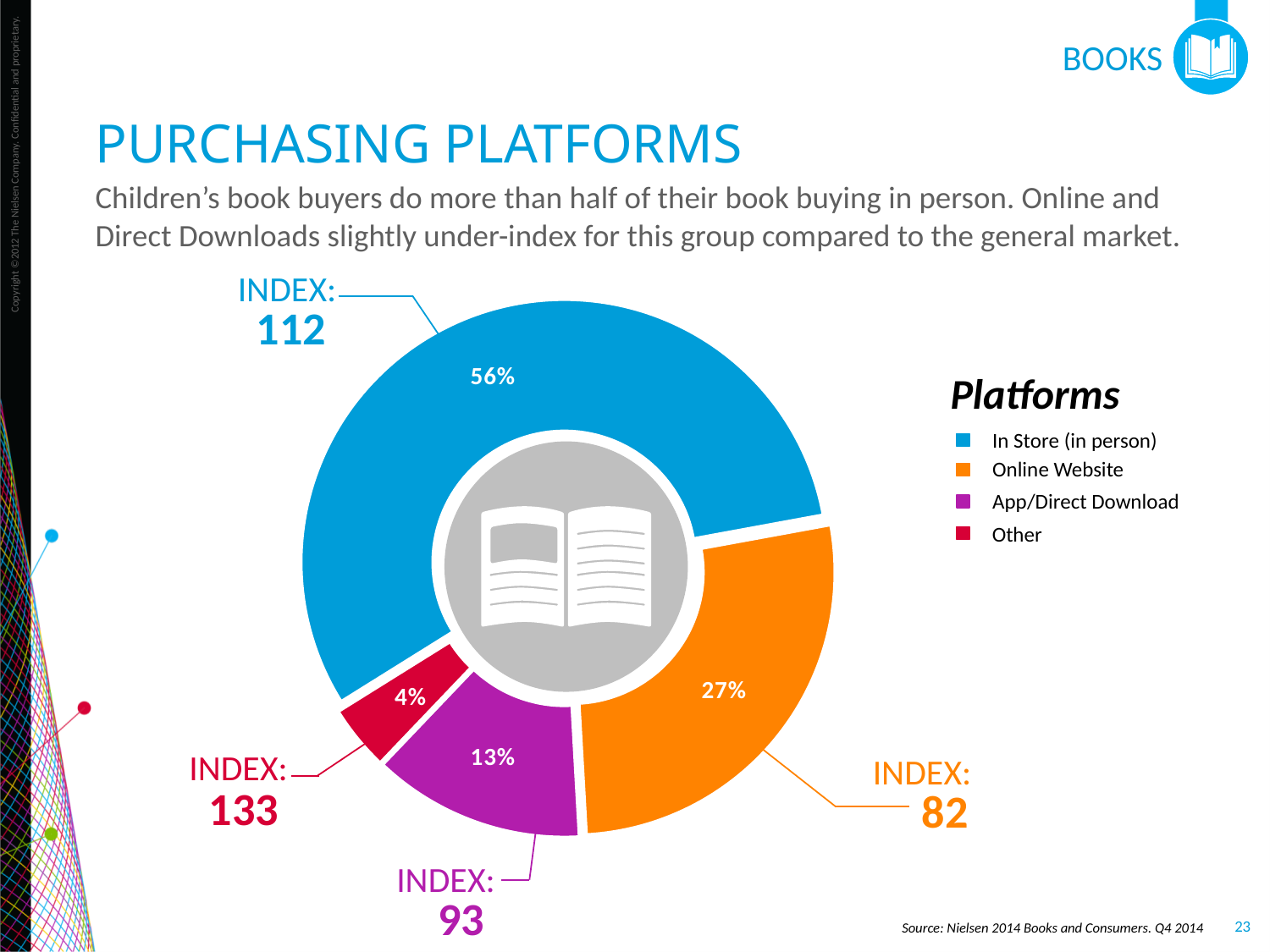
What share of children's book buying falls under Other? 4% What is the difference in share between In Store (in person) and Online Website? 29 percentage points What share of children's book buying is done In Store (in person)? 56% Which platform has the smallest share of the pie? Other How many platform categories are shown in the chart? 4 Which platform has the largest share of the pie? In Store (in person) What kind of chart is shown on the slide? Pie chart (donut) What share of children's book buying is done via App/Direct Download? 13% What is the title of the chart's legend? Platforms Which has a larger share, App/Direct Download or Other? App/Direct Download What index value is shown for the Online Website segment? 82 What share of children's book buying is done via Online Website? 27%